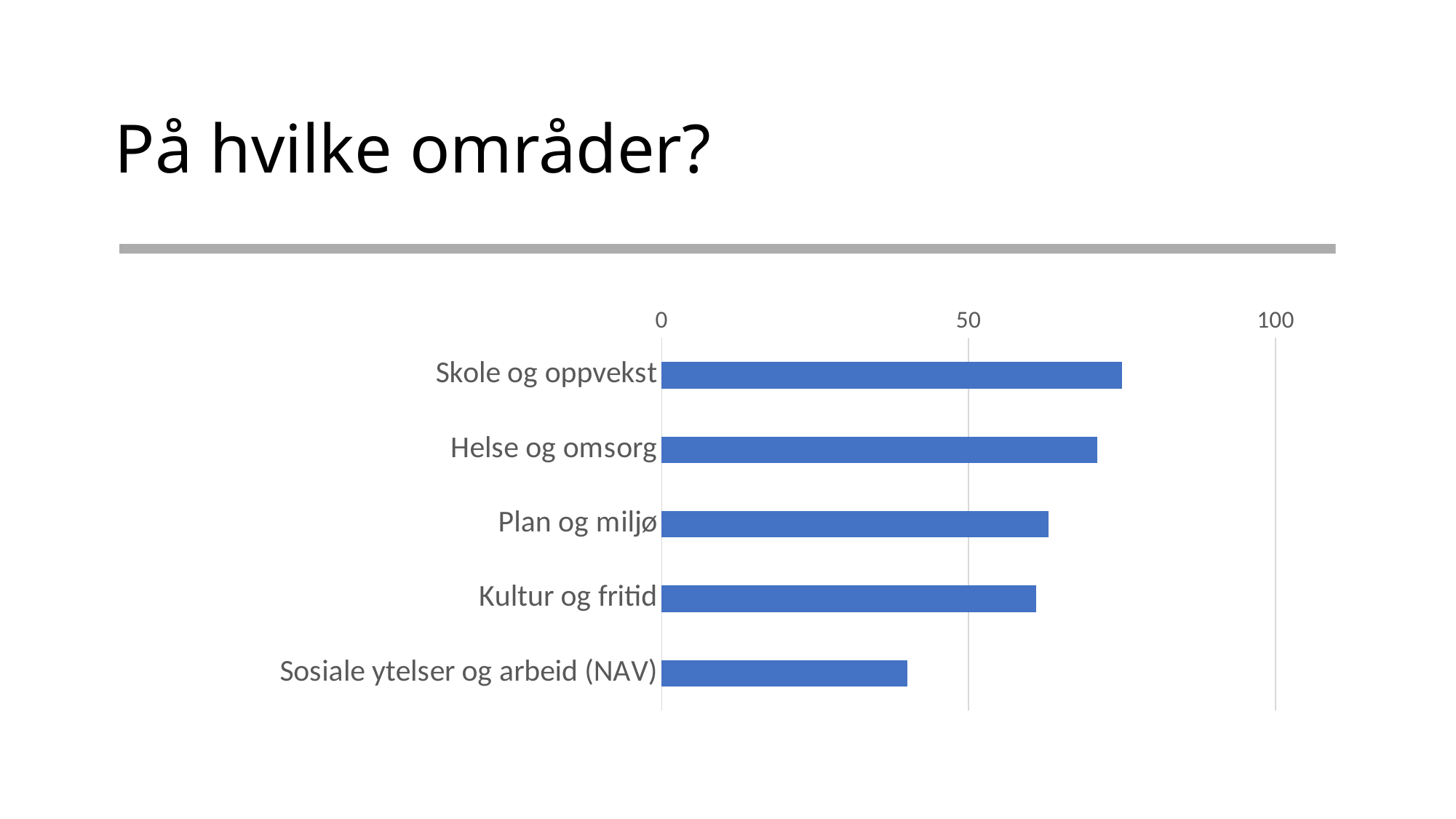
How many categories are shown in the bar chart? 5 Which category has the longest bar? Skole og oppvekst Is the value for Sosiale ytelser og arbeid (NAV) greater or less than 50? less Which category has the shortest bar? Sosiale ytelser og arbeid (NAV) Is the value for Helse og omsorg greater or less than 100? less Which is larger, the value for Plan og miljø or the value for Sosiale ytelser og arbeid (NAV)? Plan og miljø What is the highest value shown on the chart's axis? 100 Which is larger, the value for Skole og oppvekst or the value for Sosiale ytelser og arbeid (NAV)? Skole og oppvekst Is the value for Kultur og fritid greater or less than 50? greater What kind of chart is shown on the slide? Bar chart What colour are the bars in the chart? Blue